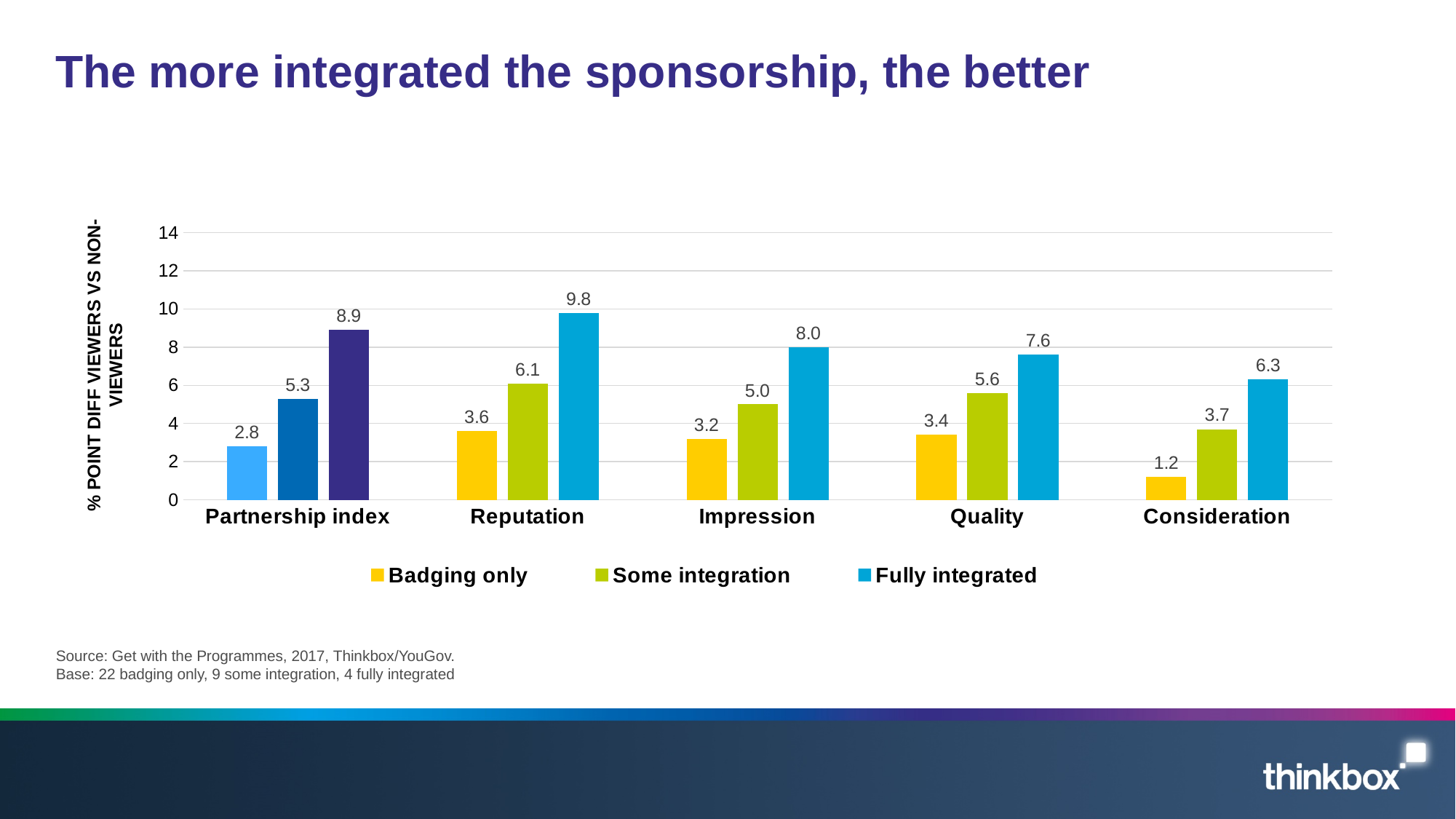
What kind of chart is shown on the slide? Bar chart How many categories are shown on the x axis? 5 Which category has the lowest Badging only value? Consideration What is the value for Fully integrated in the Reputation category? 9.8 What is the value for Badging only in the Consideration category? 1.2 Which category has the highest Fully integrated value? Reputation What is the difference between the Fully integrated and Badging only values for Impression? 4.8 What is the value for Some integration in the Quality category? 5.6 How many series does the legend list? 3 Which is larger in the Partnership index category: the Some integration value or the Badging only value? Some integration What is the title of the slide? The more integrated the sponsorship, the better Is the Fully integrated value for Quality greater or less than 6? greater